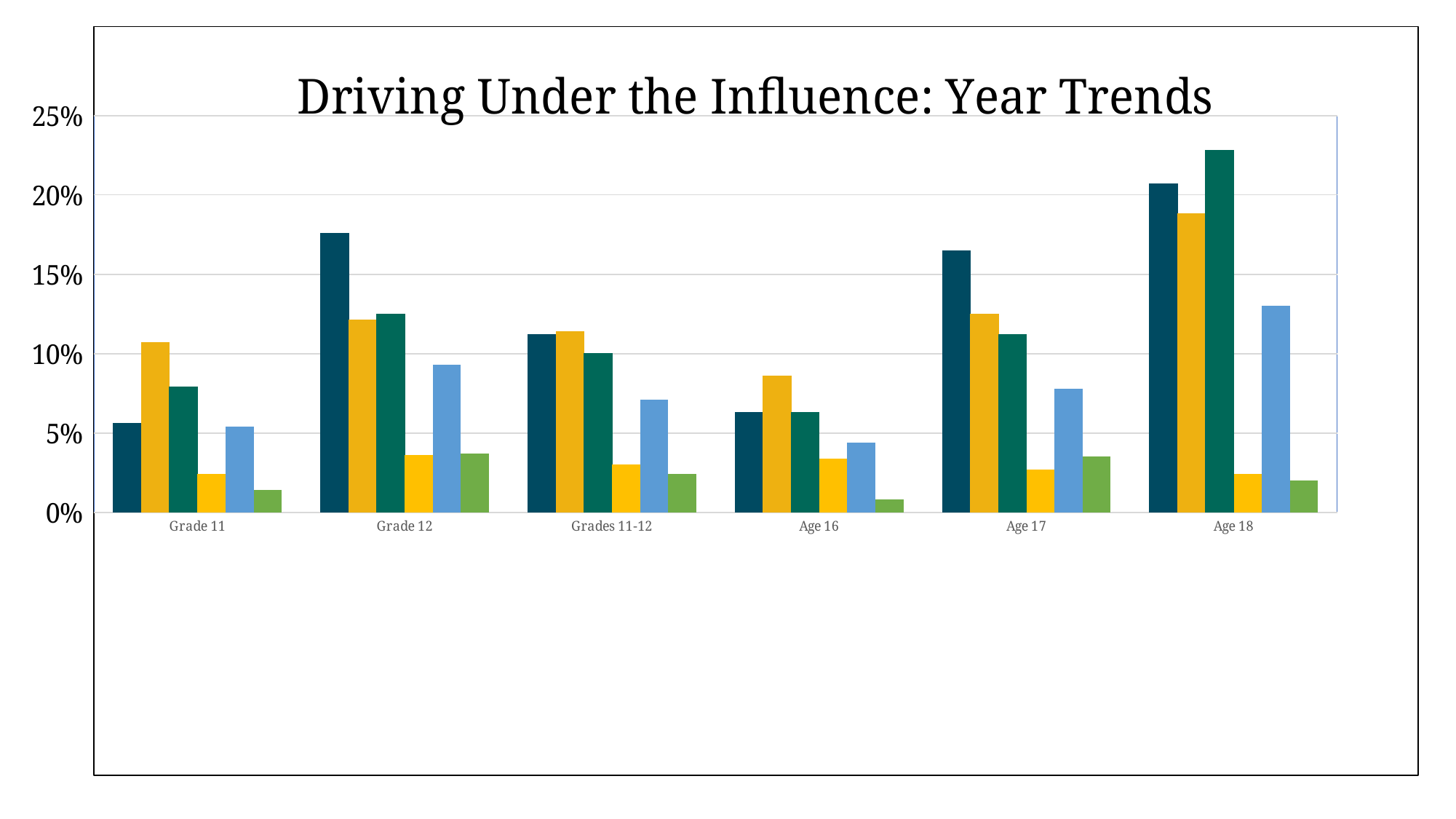
Which category's tallest bar is the lowest of all the categories? Age 16 Is the tallest bar for Age 18 greater or less than 20%? greater Is the tallest bar for Age 16 greater or less than 10%? less Is the tallest bar for Age 17 greater or less than 15%? greater What is the title of the chart? Driving Under the Influence: Year Trends What kind of chart is shown on the slide? bar chart What is the highest value labelled on the vertical axis? 25% Which category contains the tallest bar on the chart? Age 18 How many bars are plotted for each category? 6 How many categories are shown along the x axis? 6